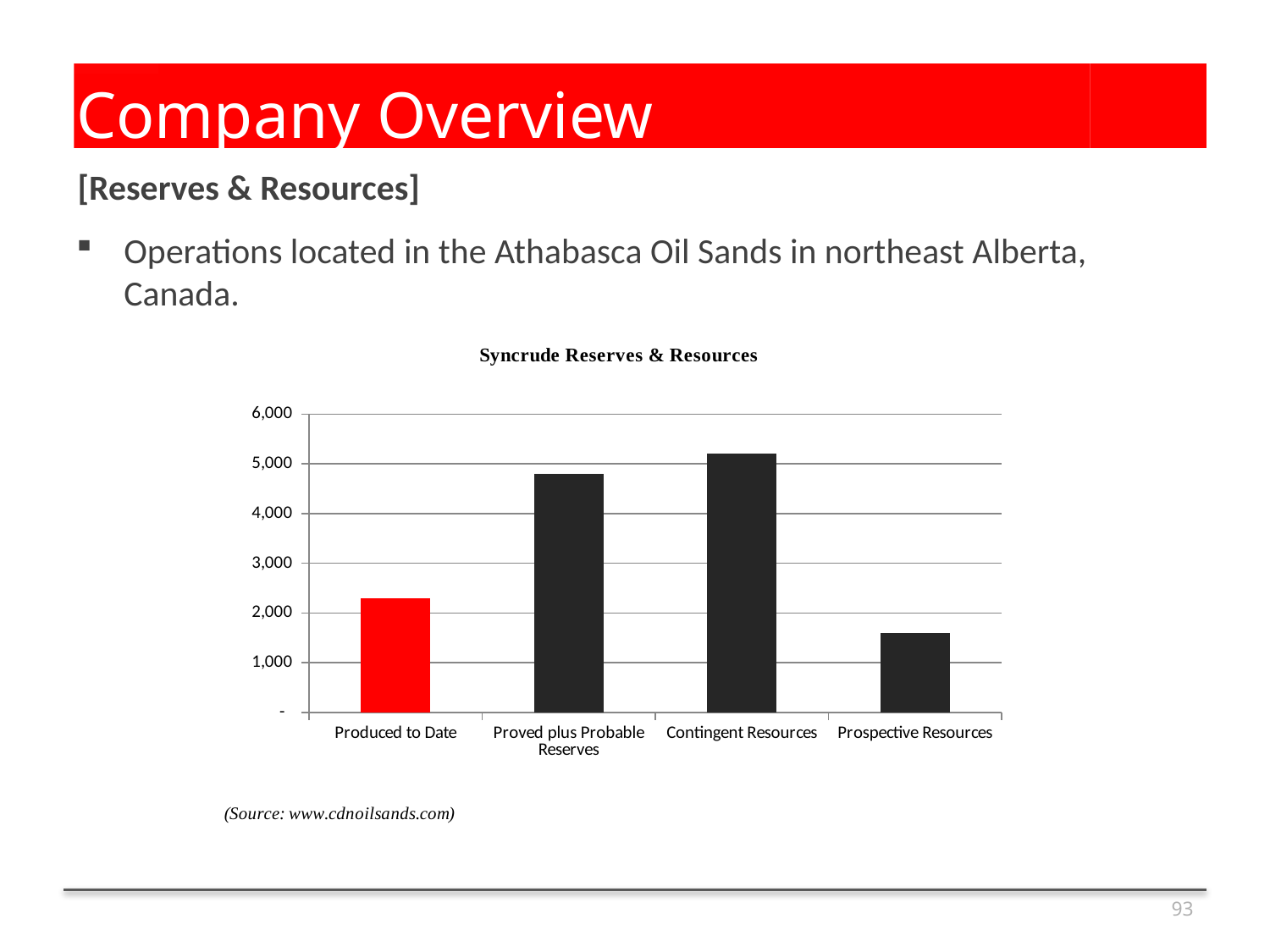
Is the value for Produced to Date greater or less than 2,000? greater What colour is the bar for Produced to Date? Red Which category has the lowest bar in the chart? Prospective Resources Which is larger, the value for Produced to Date or the value for Prospective Resources? Produced to Date How many categories are shown on the x axis of the chart? 4 What is the title of the chart? Syncrude Reserves & Resources Is the value for Proved plus Probable Reserves greater or less than 5,000? less Is the value for Prospective Resources greater or less than 2,000? less Which is larger, the value for Proved plus Probable Reserves or the value for Contingent Resources? Contingent Resources Which category has the highest bar in the chart? Contingent Resources What kind of chart is shown on the slide? Bar chart